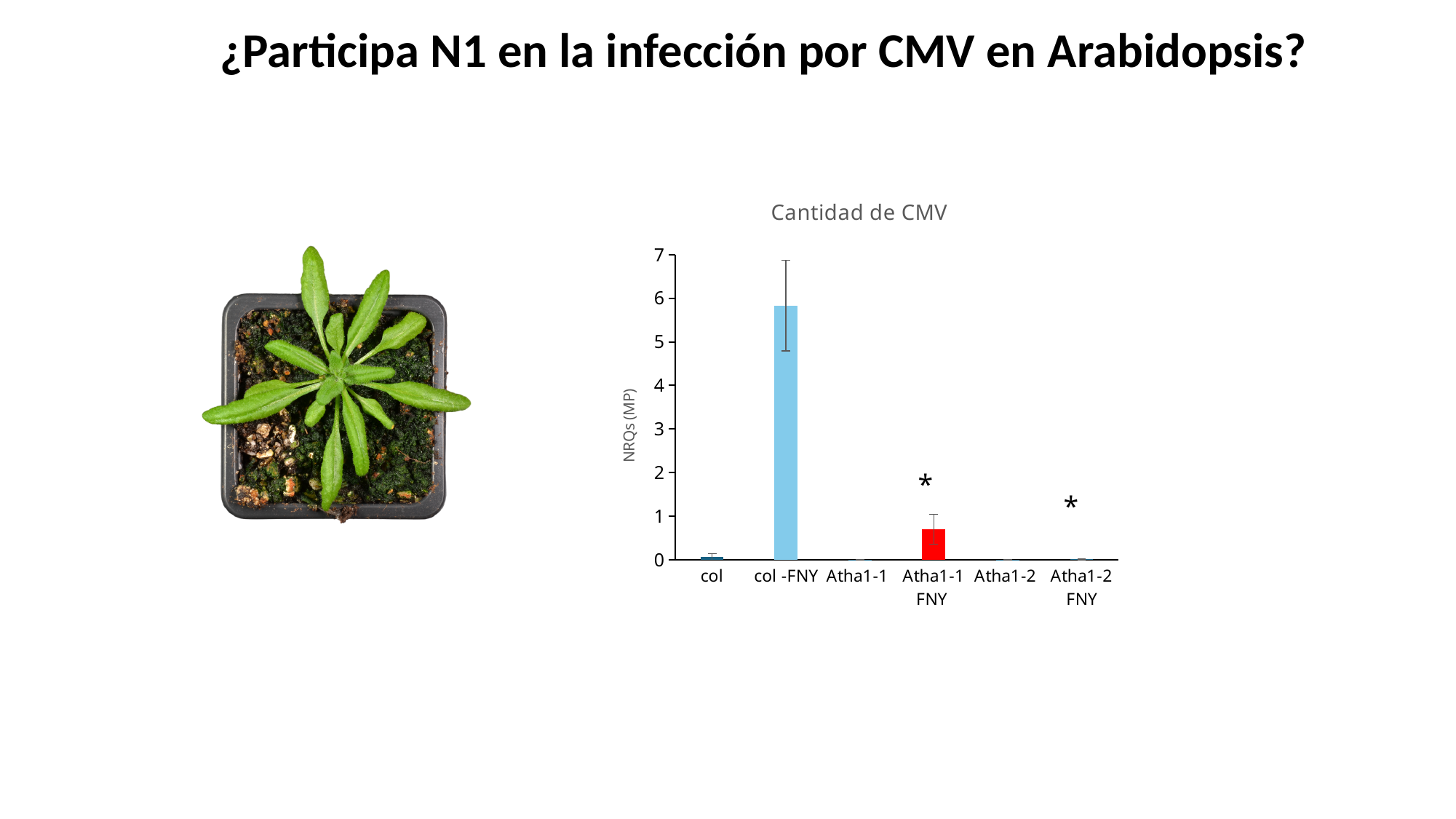
What is the title of the chart? Cantidad de CMV How many categories are shown on the x axis of the chart? 6 What kind of chart is shown on the slide? bar chart Is the value for col -FNY greater or less than 6? less What is the label of the y axis of the chart? NRQs (MP) Which is larger, the value for col -FNY or the value for Atha1-1 FNY? col -FNY Which is larger, the value for Atha1-1 FNY or the value for col? Atha1-1 FNY What is the maximum value shown on the y axis of the chart? 7 Is the value for col greater or less than 1? less Is the value for col -FNY greater or less than 5? greater Which category has the highest value in the chart? col -FNY